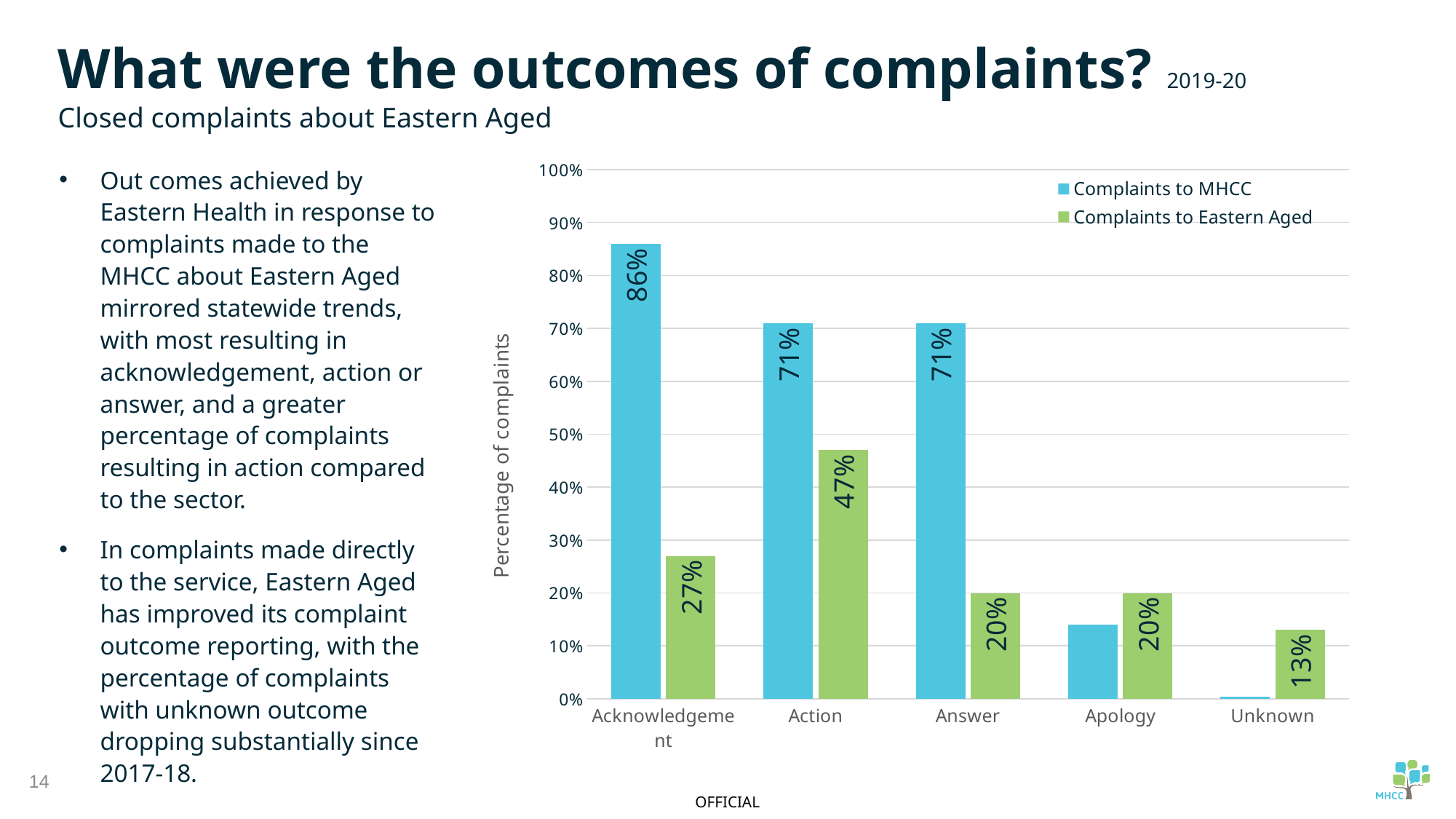
How many outcome categories are shown on the x axis? 5 What is the label of the vertical axis? Percentage of complaints How many series does the legend list? 2 Is the value for Apology in the Complaints to MHCC series greater or less than 20%? less What percentage of complaints to Eastern Aged resulted in Action? 47% Which outcome category has the lowest value for Complaints to Eastern Aged? Unknown For Apology, which series has the larger value: Complaints to MHCC or Complaints to Eastern Aged? Complaints to Eastern Aged What is the value for Unknown in the Complaints to Eastern Aged series? 13% What percentage of complaints to MHCC resulted in Acknowledgement? 86% What kind of chart is shown on the slide? bar chart Which outcome category has the highest value for Complaints to MHCC? Acknowledgement What is the difference between the Complaints to MHCC and Complaints to Eastern Aged values for Acknowledgement? 59%